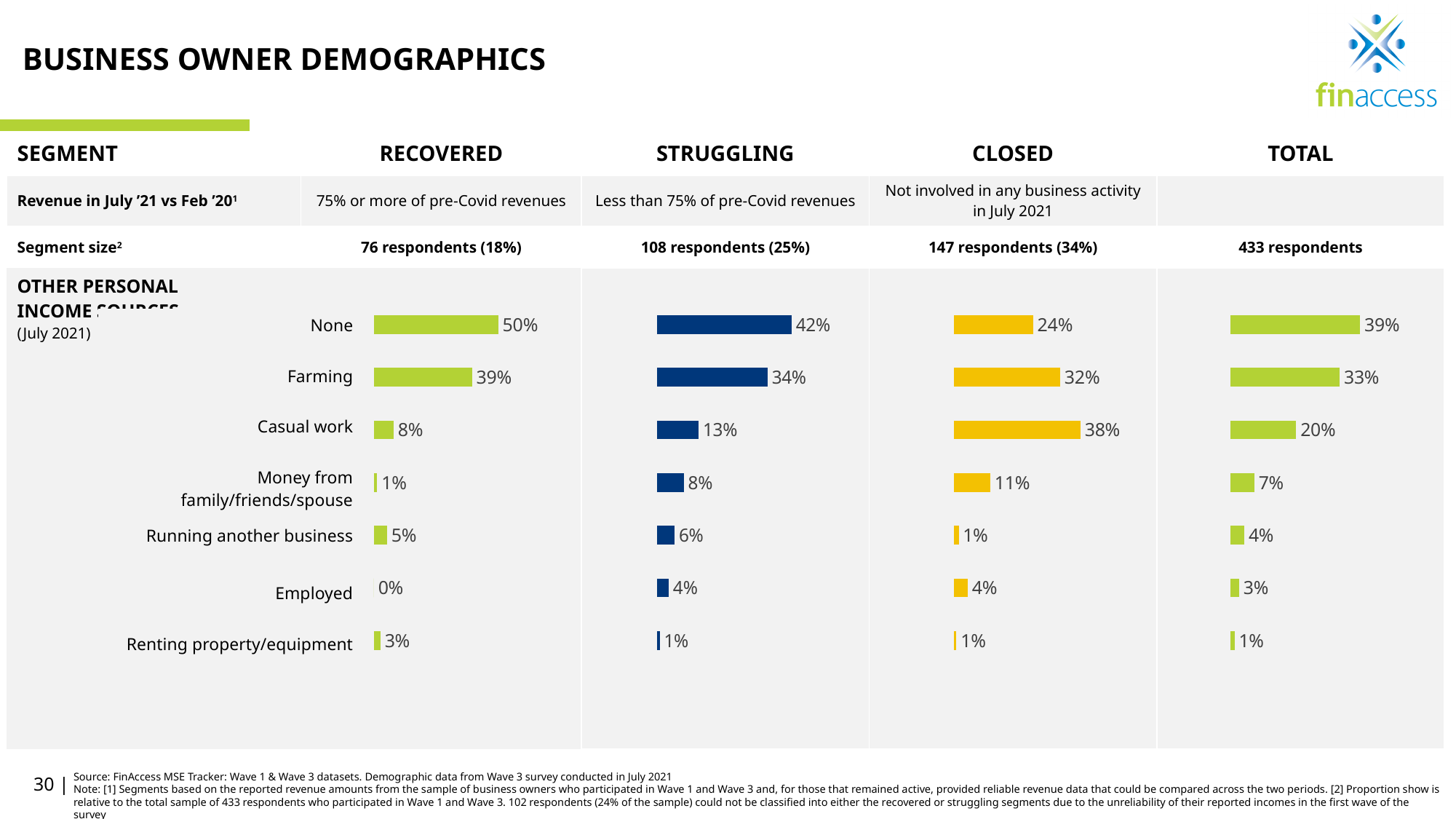
In the Recovered chart, what percentage of business owners reported 'None' as other personal income source? 50% In the Closed chart, what is the value for Casual work? 38% In the Struggling chart, what is the difference between the values for None and Farming? 8% In the Closed chart, which income source has the highest value? Casual work In the Total chart, what is the value for Money from family/friends/spouse? 7% In the Recovered chart, which income source has the lowest value? Employed In the Total chart, what is the difference between Farming and Casual work? 13% Is the value for Casual work larger in the Closed chart or the Recovered chart? Closed What colour are the bars in the Closed chart? Yellow What type of chart is used to show the other personal income sources? Bar chart In the Struggling chart, what is the value for Farming? 34% How many income source categories are shown in each chart? 7